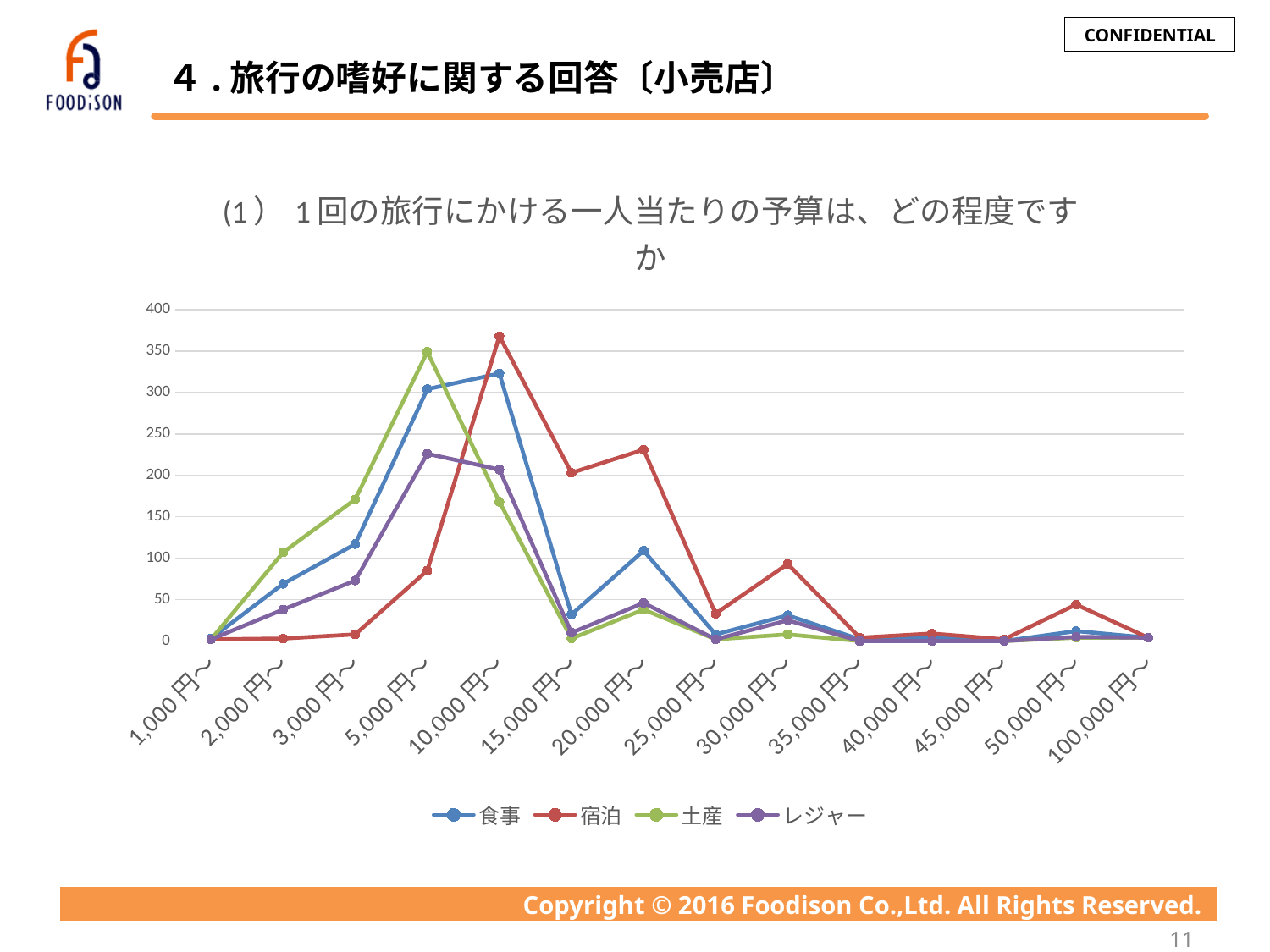
Does the 宿泊 series rise or fall from 10,000円～ to 15,000円～? fall Is the value for 宿泊 at 10,000円～ greater or less than 350? greater At which budget category does the 土産 series reach its highest value? 5,000円～ Is the value for レジャー at 5,000円～ greater or less than 200? greater Is the value for 食事 at 5,000円～ greater or less than 250? greater How many series does the legend list? 4 What kind of chart is shown on the slide? line chart At 15,000円～, which series has the higher value, 宿泊 or 食事? 宿泊 What colour is the line for the 宿泊 series? red At 5,000円～, which series has the higher value, 土産 or 食事? 土産 At which budget category does the 宿泊 series reach its highest value? 10,000円～ How many budget categories are shown along the x axis? 14